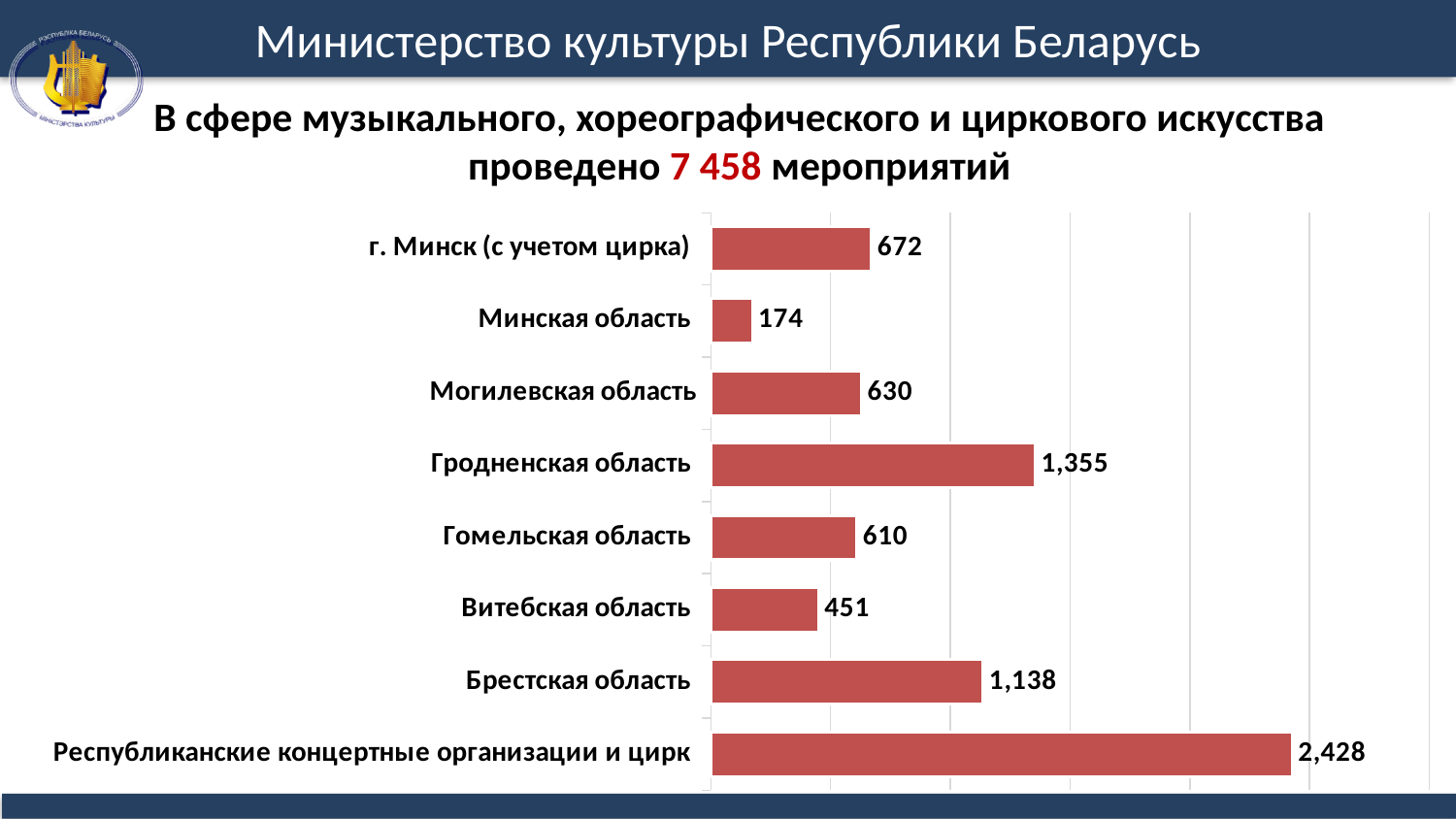
What is the value for Витебская область? 451 What is the value for Республиканские концертные организации и цирк? 2,428 How many categories are shown in the chart? 8 What is the difference between the values for г. Минск (с учетом цирка) and Могилевская область? 42 What is the value for Гродненская область? 1,355 What kind of chart is shown on the slide? Bar chart What is the difference between the values for Гродненская область and Брестская область? 217 What is the value for Минская область? 174 Which category has the lowest value? Минская область Which category has the highest value? Республиканские концертные организации и цирк What total number of events is stated in the slide heading? 7 458 Which is larger, the value for Брестская область or the value for Гомельская область? Брестская область